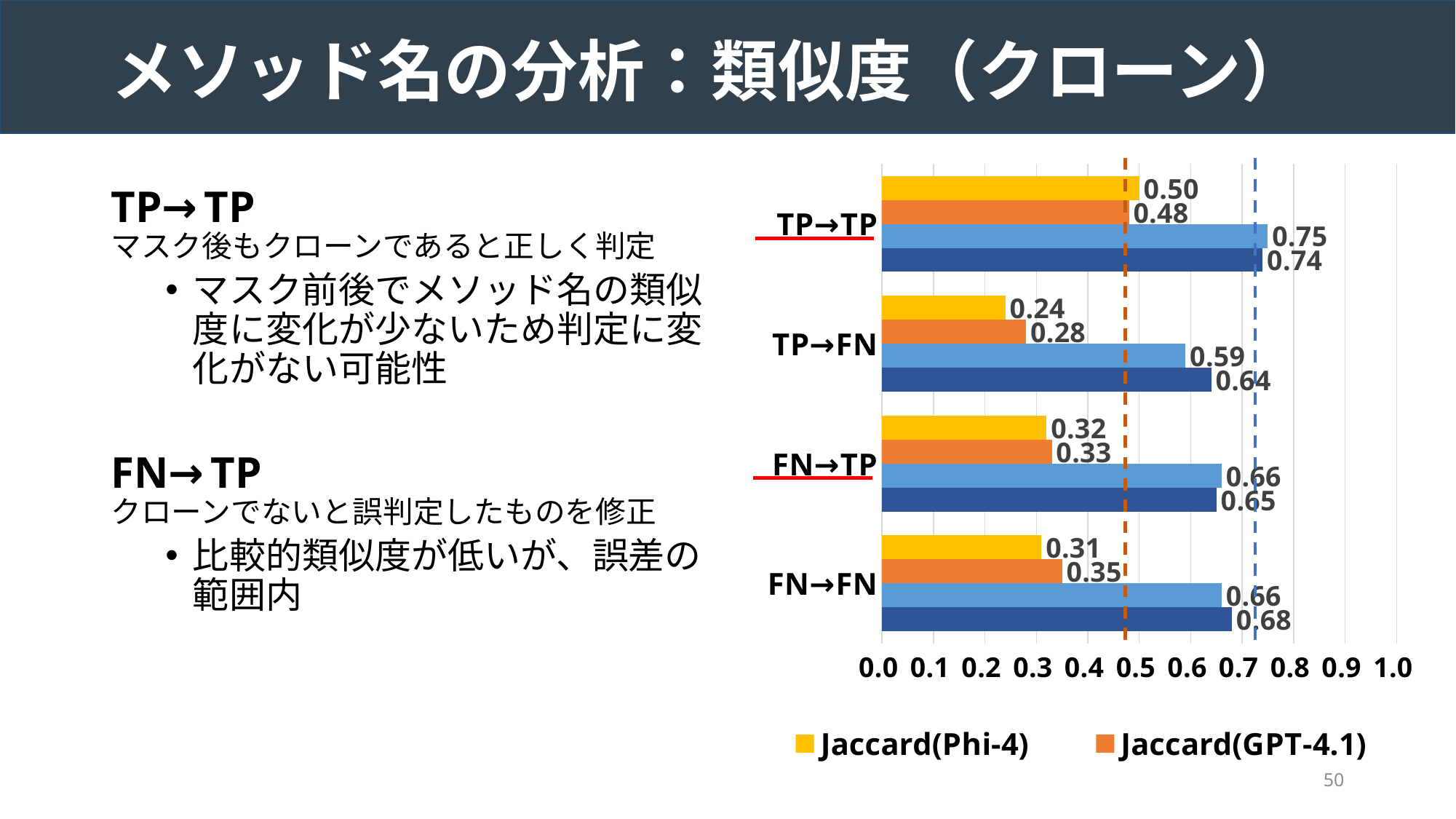
How many categories are shown on the vertical axis of the chart? 4 Is the Jaccard(Phi-4) value for FN→TP greater or less than 0.4? less Which category has the lowest Jaccard(Phi-4) value? TP→FN How many series does the chart's legend list? 2 What is the Jaccard(GPT-4.1) value for FN→TP? 0.33 Which category has the lowest Jaccard(GPT-4.1) value? TP→FN For FN→FN, which is larger: Jaccard(Phi-4) or Jaccard(GPT-4.1)? Jaccard(GPT-4.1) What is the Jaccard(GPT-4.1) value for TP→FN? 0.28 What is the difference between the Jaccard(GPT-4.1) values for TP→TP and TP→FN? 0.20 What kind of chart is shown on the slide? bar chart Which category has the highest Jaccard(Phi-4) value? TP→TP What is the Jaccard(Phi-4) value for TP→TP? 0.50